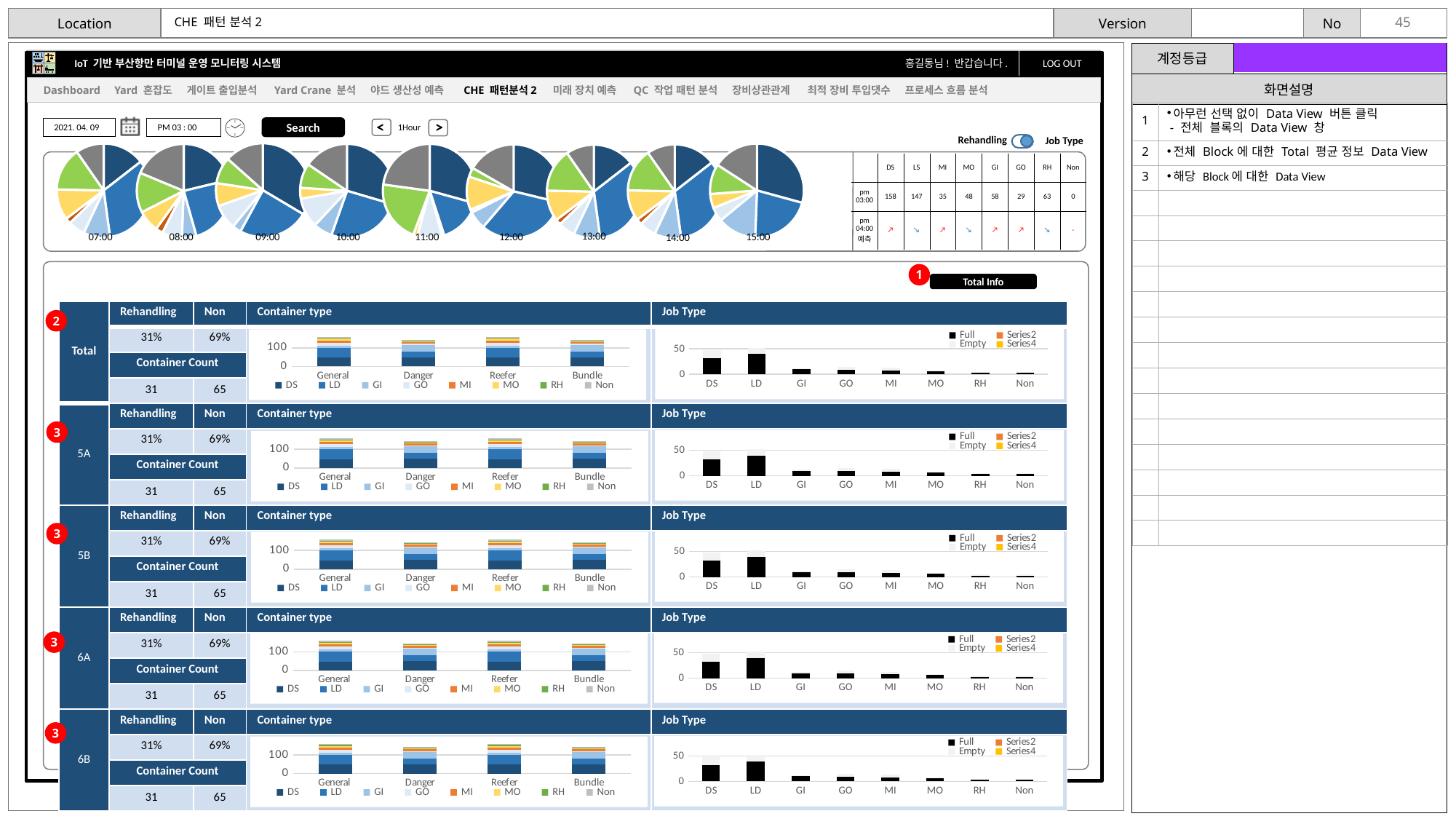
What time label appears under the last pie chart in the top row? 15:00 How many series does the legend of the 'Job Type' chart in the 5A row list? 4 What time label appears under the first pie chart in the top row? 07:00 How many categories are shown on the x axis of the 'Job Type' chart in the Total row? 8 What kind of chart is the 'Container type' chart in the Total row? bar chart In the 'Job Type' chart of the Total row, which category has the highest bar? LD How many categories are shown on the x axis of the 'Container type' chart in the Total row? 4 How many series does the legend of the 'Container type' chart in the Total row list? 8 How many pie charts are shown in the top row of the dashboard? 9 What kind of chart is the 'Job Type' chart in the Total row? bar chart In the 'Job Type' chart of the 6A row, which is larger, the bar for DS or the bar for GI? DS